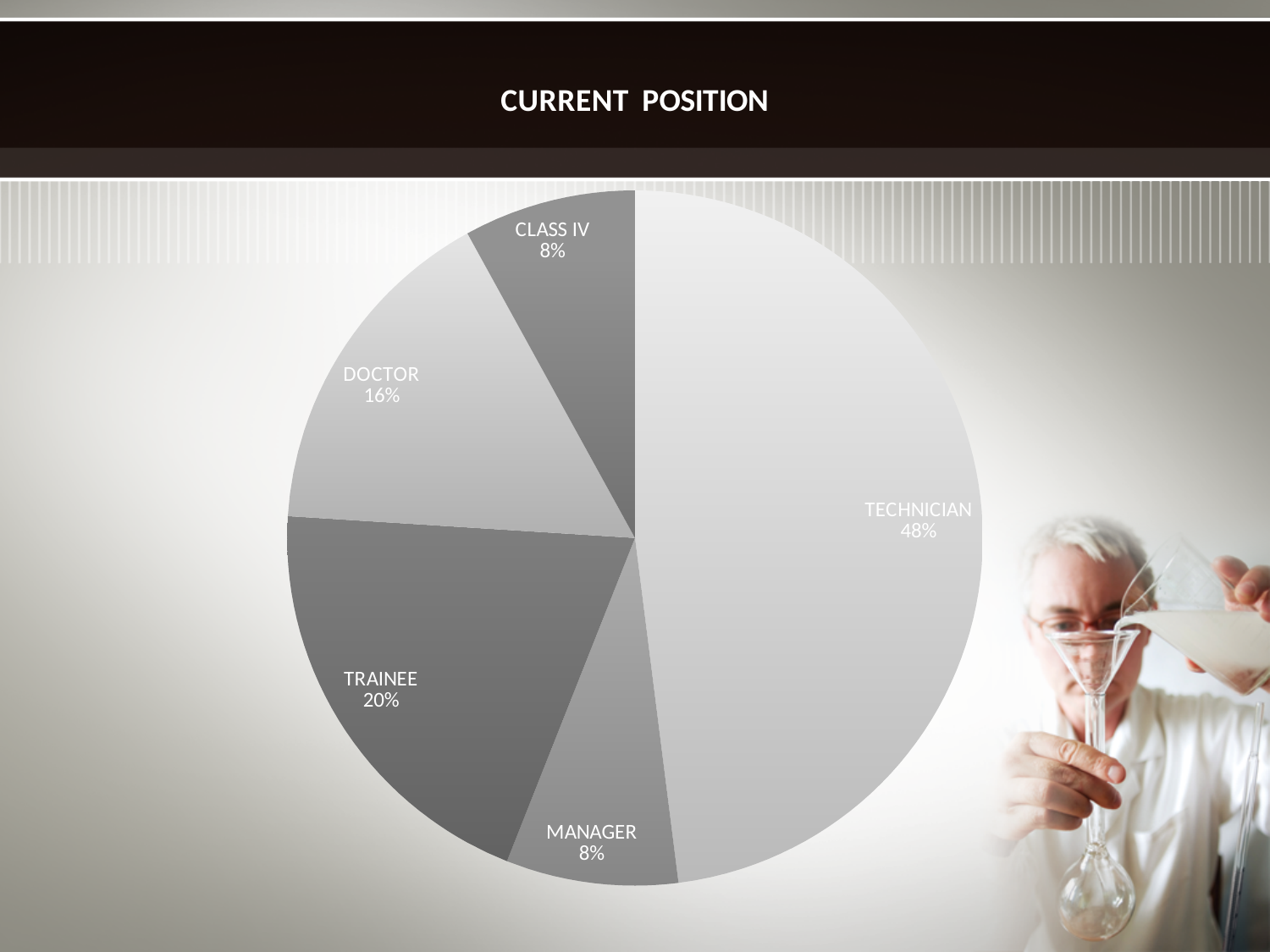
Which is larger, the DOCTOR slice or the CLASS IV slice? DOCTOR What percentage of the pie is MANAGER? 8% Which two categories share the same percentage? CLASS IV and MANAGER How many slices does the pie chart have? 5 What is the difference in percentage points between TECHNICIAN and TRAINEE? 28 What percentage of the pie is TECHNICIAN? 48% Which category has the largest share of the pie? TECHNICIAN What is the title of the slide containing the chart? CURRENT POSITION What percentage of the pie is DOCTOR? 16% What percentage of the pie is TRAINEE? 20% What kind of chart is shown on the slide? pie chart What is the difference in percentage points between DOCTOR and MANAGER? 8